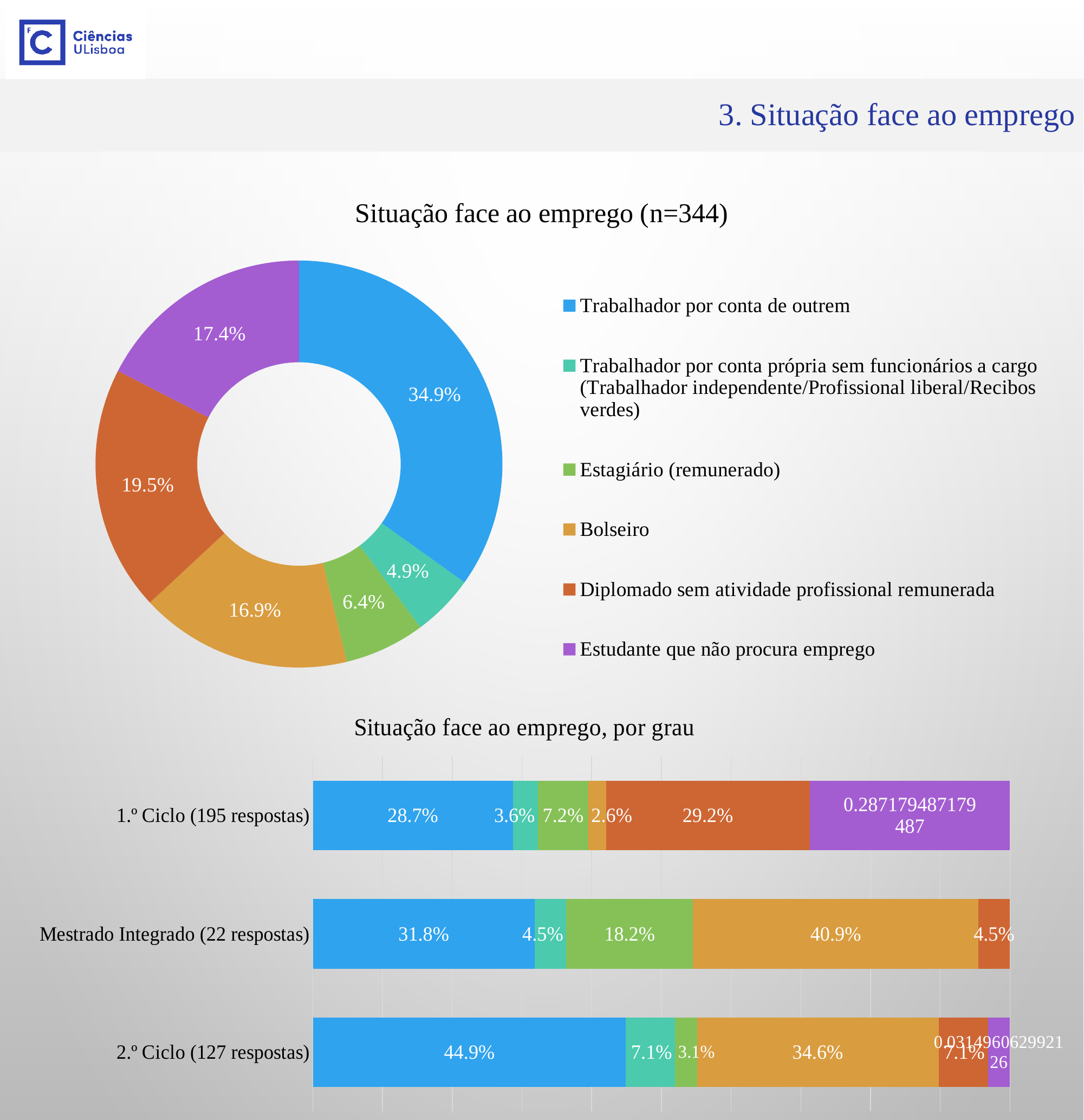
In the doughnut chart 'Situação face ao emprego (n=344)', how many categories does the legend list? 6 In the doughnut chart 'Situação face ao emprego (n=344)', what share is labelled for Bolseiro? 16.9% In the bar chart 'Situação face ao emprego, por grau', which degree has the larger blue segment (Trabalhador por conta de outrem): 1.º Ciclo or 2.º Ciclo? 2.º Ciclo In the doughnut chart 'Situação face ao emprego (n=344)', what is the difference between the shares for Diplomado sem atividade profissional remunerada and Estudante que não procura emprego? 2.1% In the bar chart 'Situação face ao emprego, por grau', what is the value of the blue segment (Trabalhador por conta de outrem) for 2.º Ciclo (127 respostas)? 44.9% What kind of chart is 'Situação face ao emprego, por grau'? Stacked bar chart In the bar chart 'Situação face ao emprego, por grau', what is the value of the orange segment (Bolseiro) for Mestrado Integrado (22 respostas)? 40.9% In the doughnut chart 'Situação face ao emprego (n=344)', what share is labelled for Trabalhador por conta de outrem? 34.9% In the bar chart 'Situação face ao emprego, por grau', how many degree categories are shown? 3 In the doughnut chart 'Situação face ao emprego (n=344)', which category has the smallest share? Trabalhador por conta própria sem funcionários a cargo What kind of chart is 'Situação face ao emprego (n=344)'? Doughnut chart In the doughnut chart 'Situação face ao emprego (n=344)', which category has the largest share? Trabalhador por conta de outrem